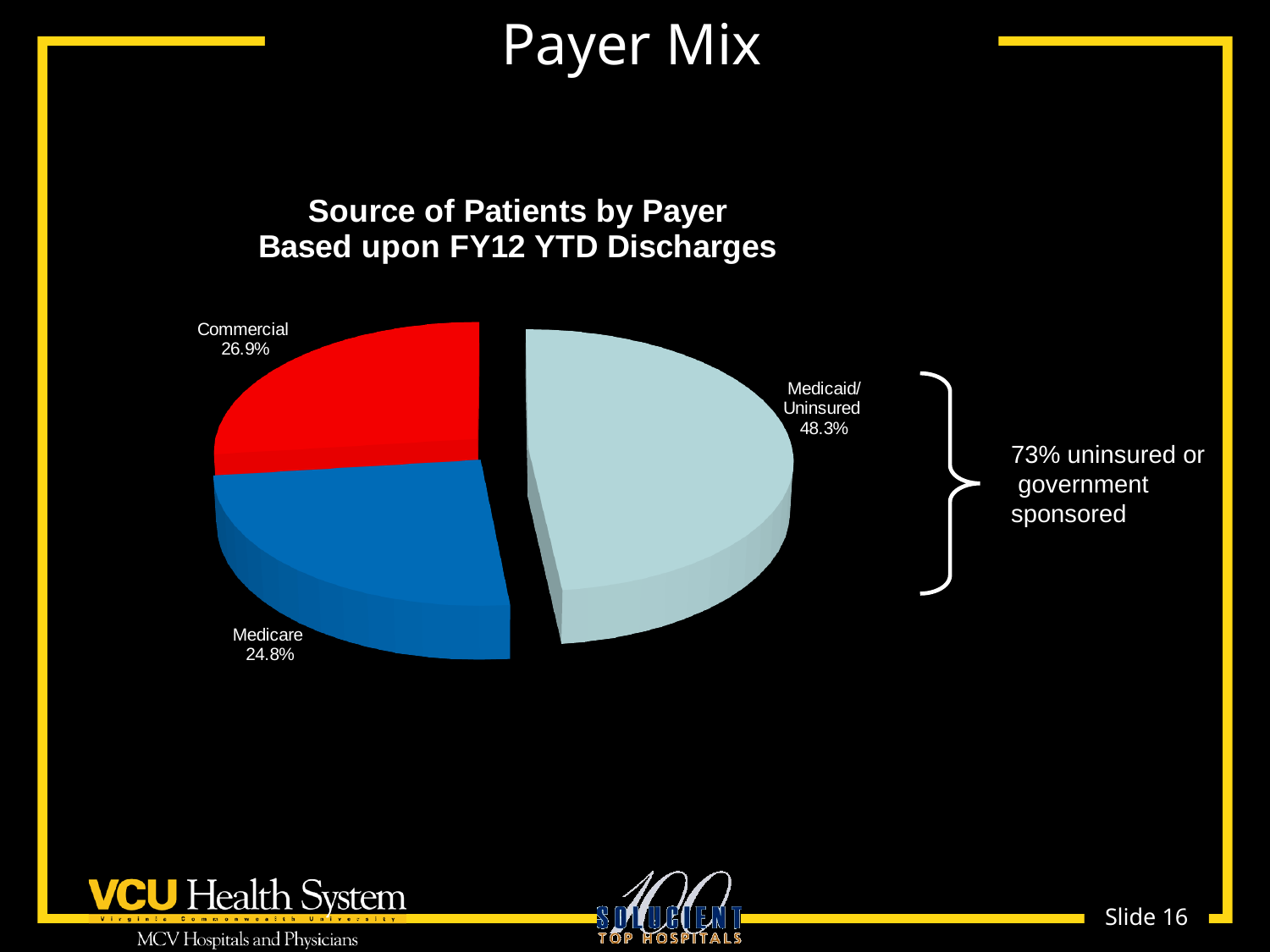
What share of patients is Medicaid/Uninsured? 48.3% What is the title of the chart? Source of Patients by Payer Based upon FY12 YTD Discharges Which is larger, the Commercial share or the Medicare share? Commercial What is the difference in percentage points between the Commercial share and the Medicare share? 2.1 Which payer category has the smallest share of patients? Medicare Which payer category has the largest share of patients? Medicaid/Uninsured What colour is the Commercial slice of the pie? Red What share of patients is Commercial? 26.9% What kind of chart is shown on the slide? Pie chart What is the difference in percentage points between the Medicaid/Uninsured share and the Commercial share? 21.4 How many payer categories are shown in the pie chart? 3 What share of patients is Medicare? 24.8%